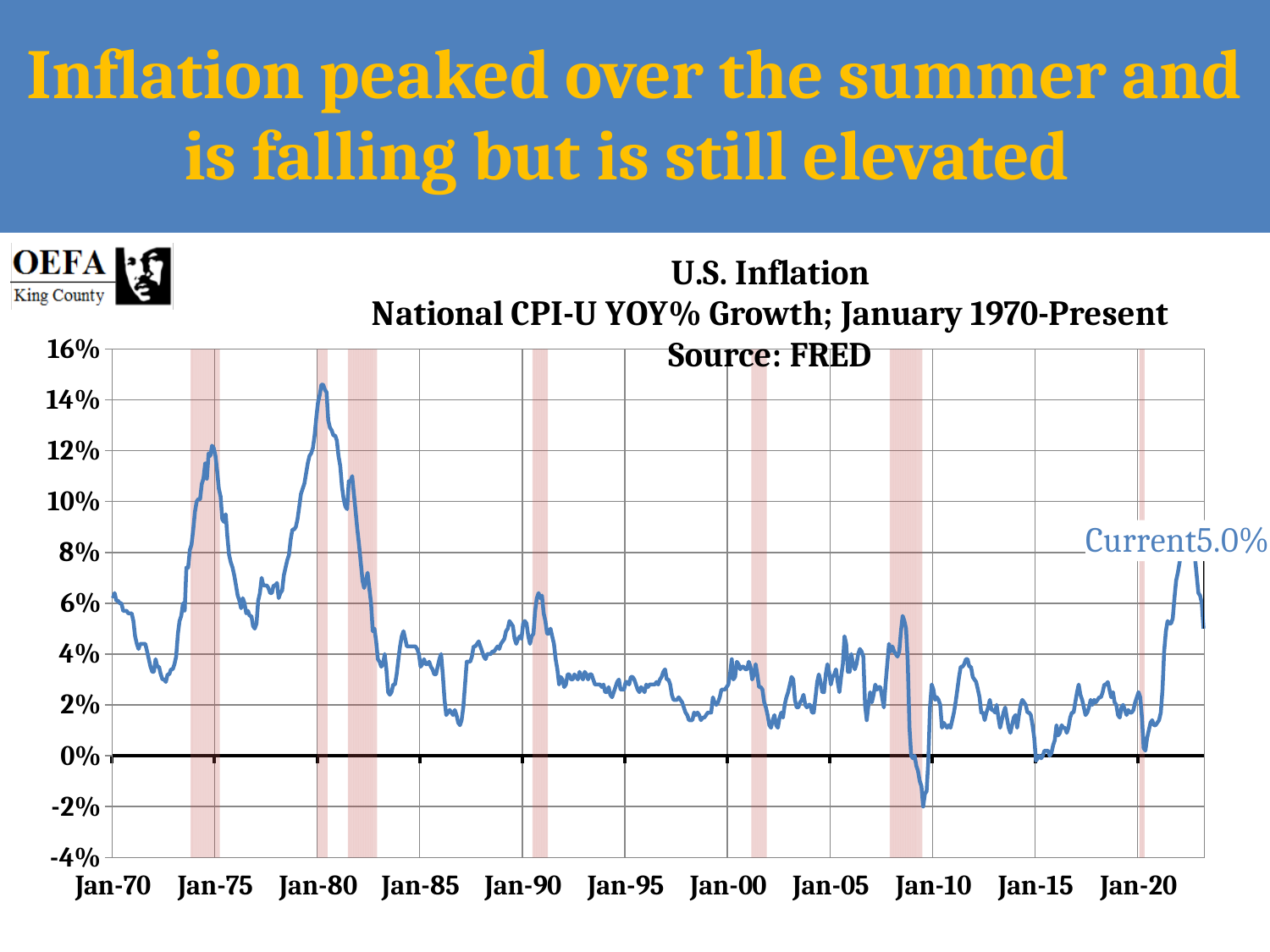
Does the line rise or fall between Jan-80 and Jan-85? fall What is the current inflation value labeled on the chart? 5.0% Is the peak value near Jan-80 greater or less than 12%? greater Is the lowest value near Jan-10 greater or less than 0%? less What kind of chart is shown on the slide? line chart What is the title of the chart? U.S. Inflation Which peak is higher, the one near Jan-75 or the one near Jan-80? Jan-80 What source is cited for the chart's data? FRED Near which x-axis label does the line reach its highest value? Jan-80 Near which x-axis label does the line reach its lowest value? Jan-10 Is the value at Jan-70 greater or less than 4%? greater How many labels are shown on the x axis? 11